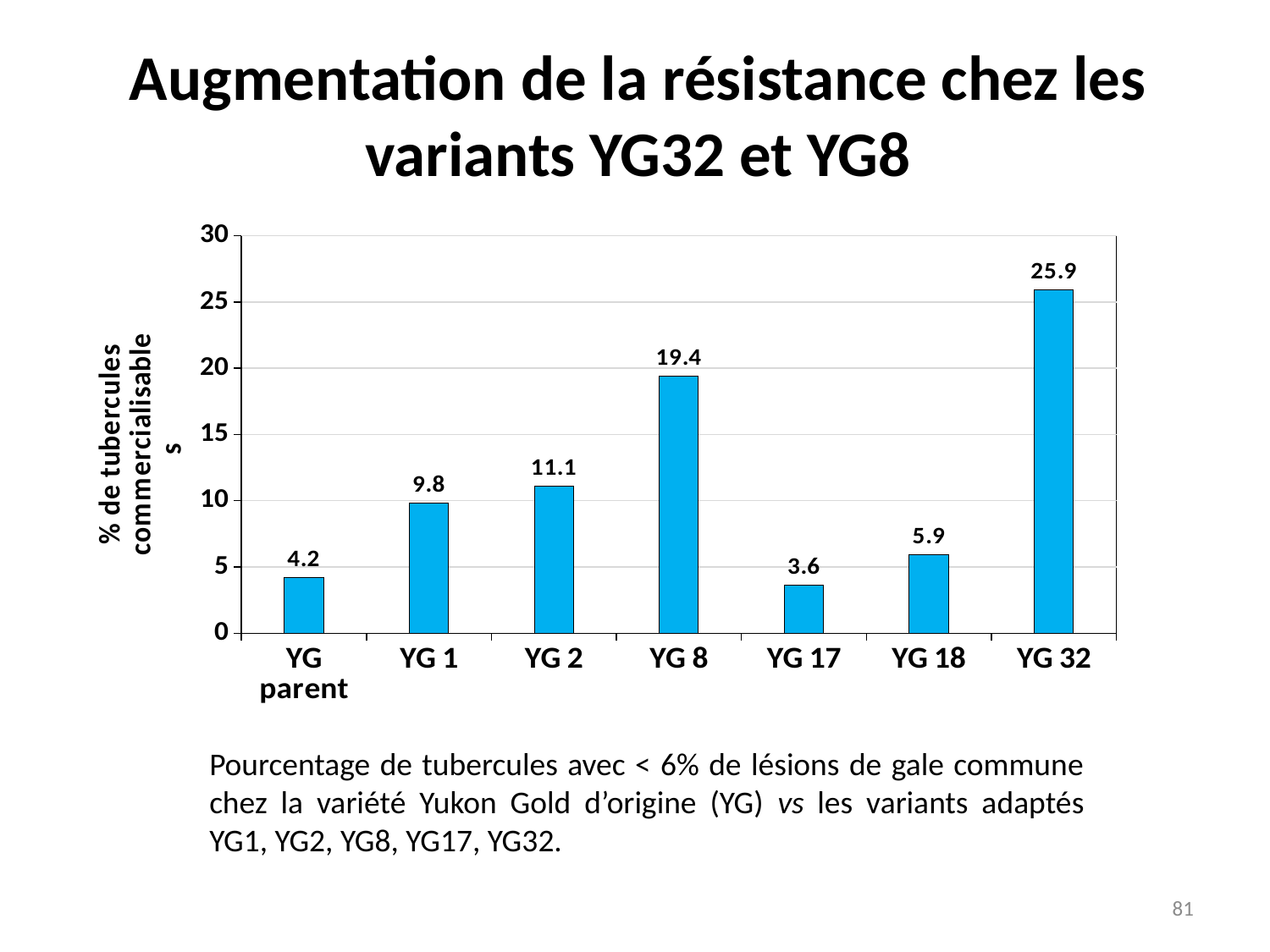
What is the value for YG parent? 4.2 Is the value for YG 32 greater or less than 25? greater What is the title of the slide? Augmentation de la résistance chez les variants YG32 et YG8 What is the difference between the values for YG 32 and YG 8? 6.5 Which category has the highest value? YG 32 What is the difference between the values for YG 2 and YG 1? 1.3 What kind of chart is shown on the slide? bar chart What is the value for YG 18? 5.9 Which is larger, the value for YG 1 or the value for YG 18? YG 1 What is the value for YG 8? 19.4 How many categories are shown on the x axis? 7 Which category has the lowest value? YG 17